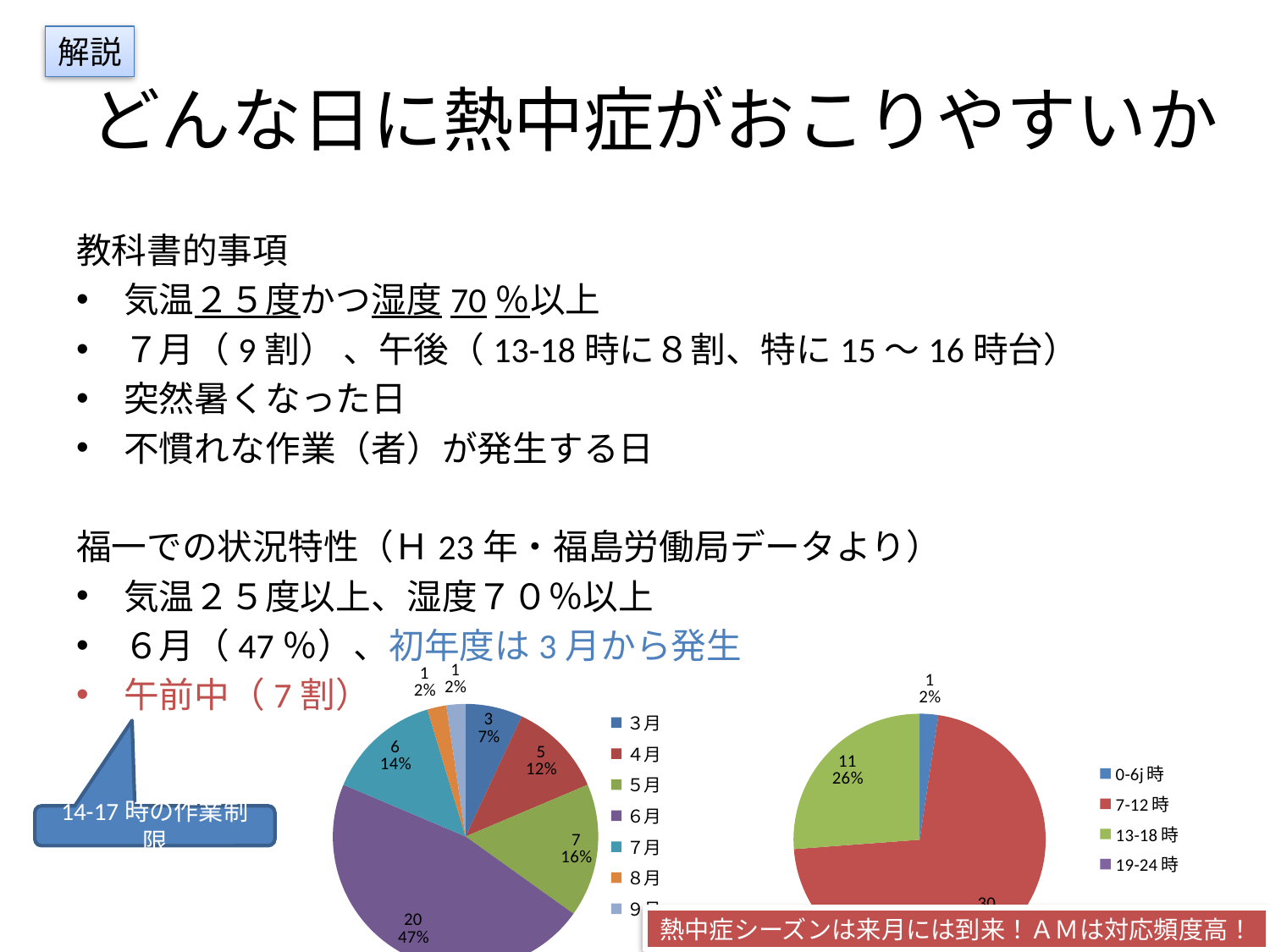
In the left pie chart of months, what share does 4月 have? 12% What kind of chart is the left chart showing months (3月 to 9月)? pie chart In the left pie chart of months, which has the larger count, 5月 or 7月? 5月 In the left pie chart of months, what is the difference between the counts for 6月 and 5月? 13 In the left pie chart of months, what is the count shown for 6月? 20 In the right pie chart of time bands, what share does 13-18時 have? 26% In the left pie chart of months, what share does 6月 have? 47% In the right pie chart of time bands, which time band has the largest slice? 7-12時 How many categories does the legend of the left pie chart of months list? 7 In the left pie chart of months, which month has the largest slice? 6月 In the left pie chart of months, what is the count shown for 5月? 7 In the right pie chart of time bands, what is the count shown for 0-6j時? 1